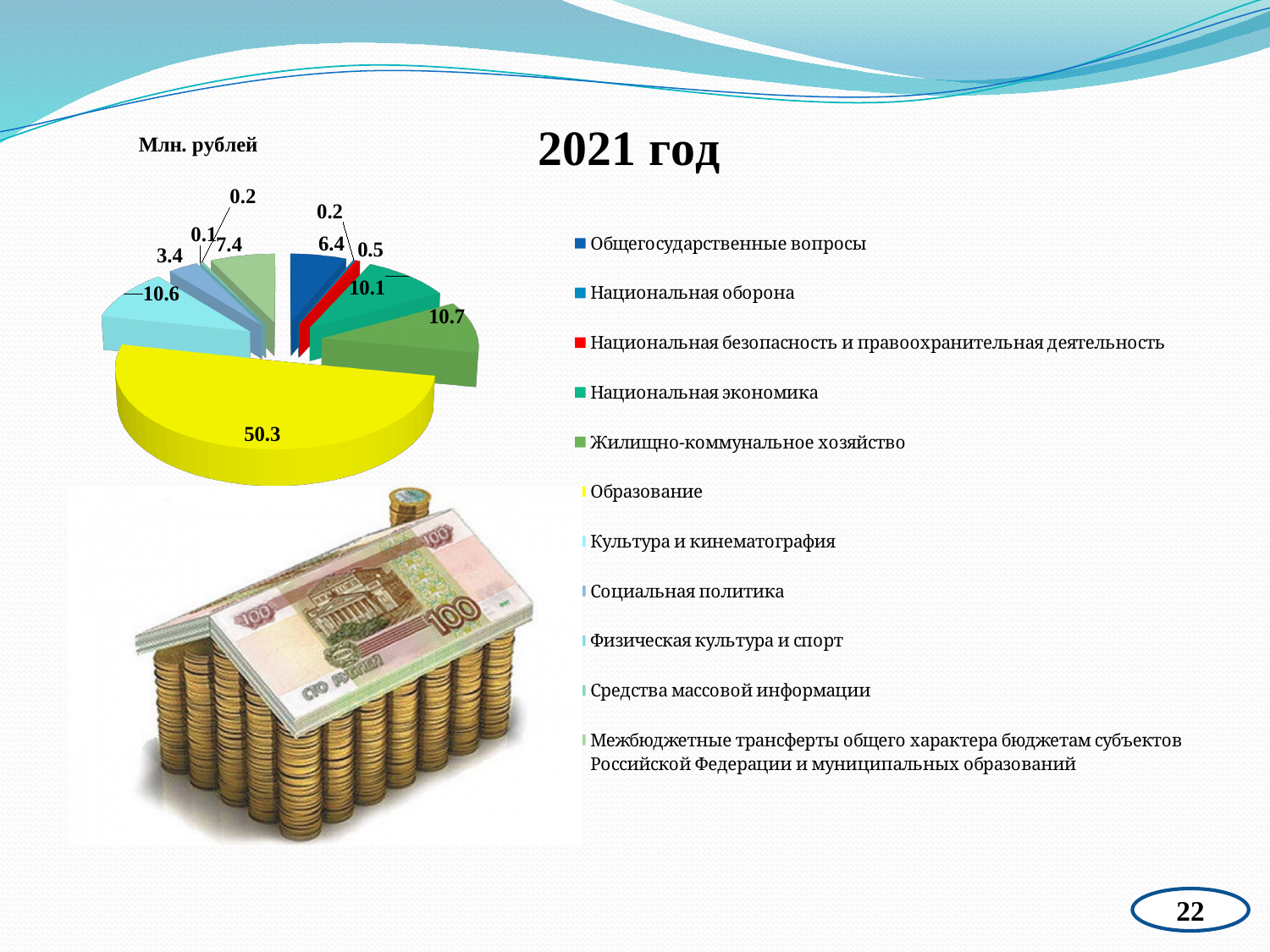
What is the value shown for Общегосударственные вопросы in the pie chart? 6.4 How many categories does the legend of the pie chart list? 11 What is the value shown for Национальная безопасность и правоохранительная деятельность in the pie chart? 0.5 What is the difference between the values for Образование and Жилищно-коммунальное хозяйство? 39.6 Which category has the largest slice in the pie chart? Образование What is the value shown for Национальная экономика in the pie chart? 10.1 In what units are the values of the pie chart given, according to the label above it? Млн. рублей What is the value shown for Жилищно-коммунальное хозяйство in the pie chart? 10.7 What is the value shown for Образование in the pie chart? 50.3 What kind of chart is shown on the slide? pie chart Which is larger: the value for Жилищно-коммунальное хозяйство or the value for Национальная экономика? Жилищно-коммунальное хозяйство Which year does the slide title say the chart refers to? 2021 год